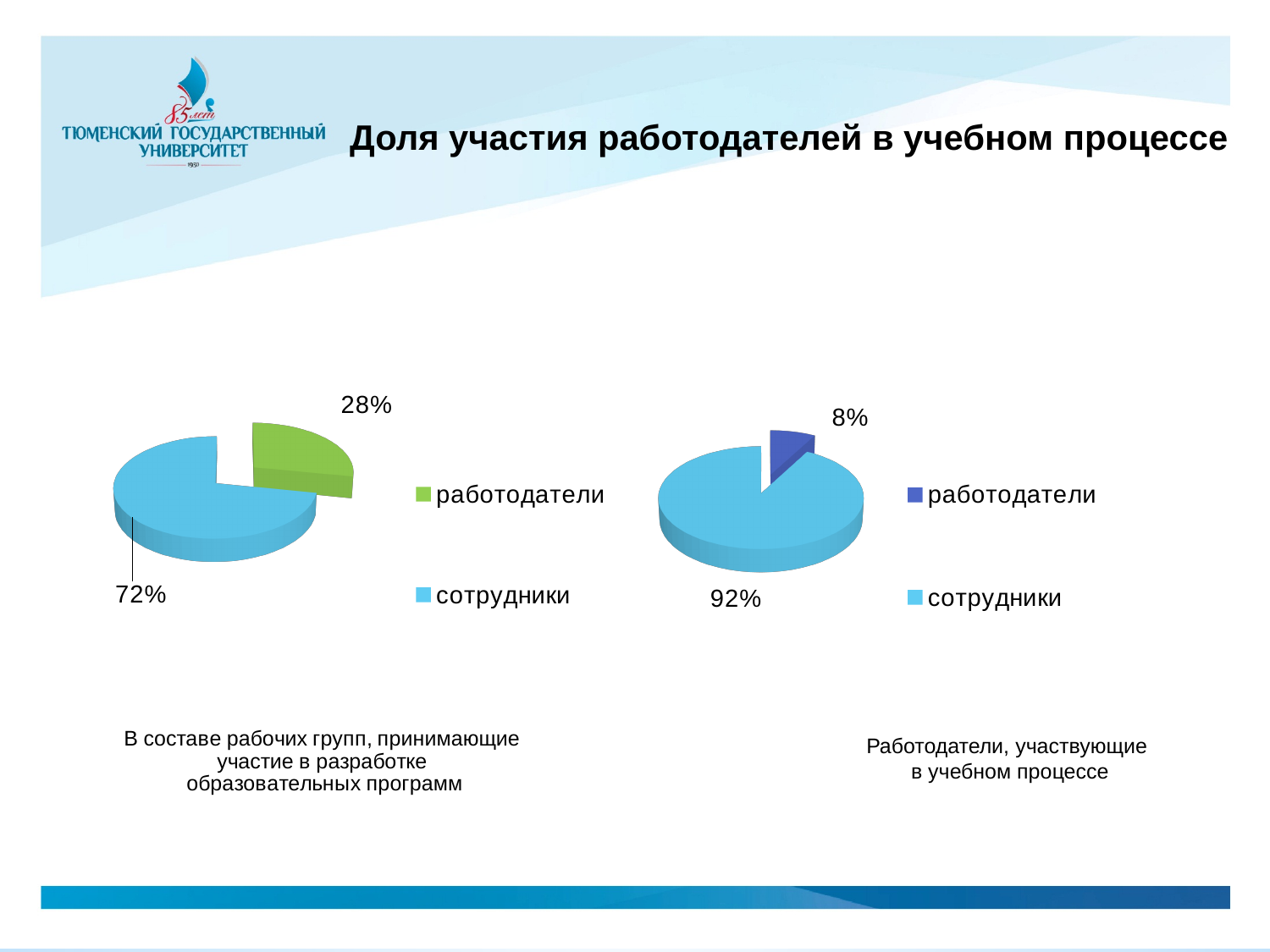
On the left pie chart (working groups developing educational programmes), what share is labelled for сотрудники? 72% What type of chart is used on the left side of the slide? pie chart What colour is the работодатели slice on the left pie chart? green On the right pie chart, which category has the smallest slice? работодатели How many entries does the legend of the left pie chart list? 2 On the left pie chart, what is the difference between the сотрудники share and the работодатели share? 44% On the left pie chart (working groups developing educational programmes), what share is labelled for работодатели? 28% On the right pie chart (employers participating in the educational process), what share is labelled for сотрудники? 92% On the left pie chart, which category has the largest slice? сотрудники On the right pie chart (employers participating in the educational process), what share is labelled for работодатели? 8% Is the работодатели share larger on the left pie chart or on the right pie chart? left pie chart How many slices does the right pie chart have? 2